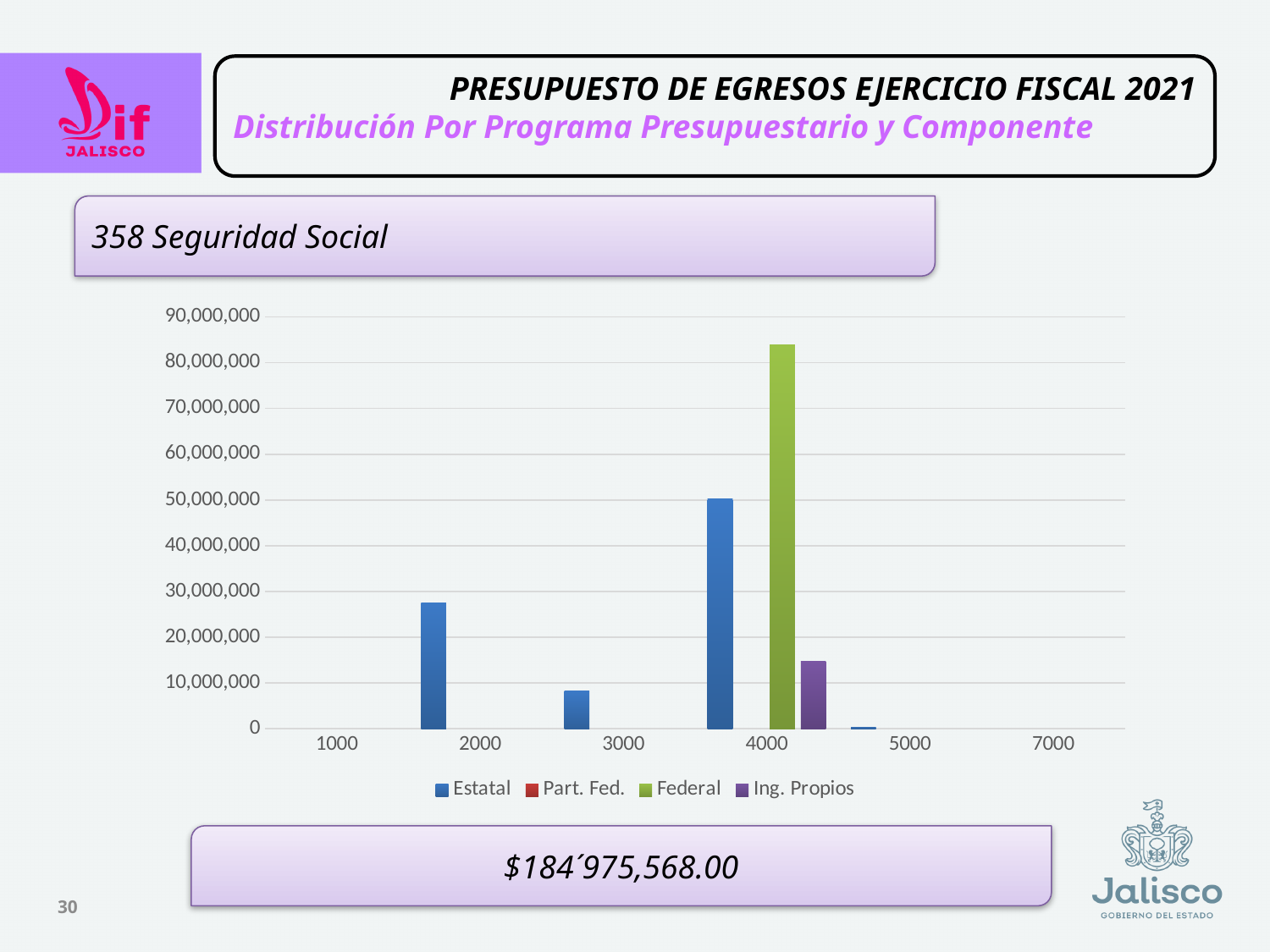
What is the title of the program shown above the chart? 358 Seguridad Social Is the Estatal value for category 2000 greater or less than 30,000,000? less What colour represents the Federal series in the legend? green How many series does the legend list? 4 What kind of chart is shown on the slide? bar chart Is the Federal value for category 4000 greater or less than 80,000,000? greater How many categories are shown on the x axis? 6 Which category has the tallest Estatal bar? 4000 Is the Estatal value for category 4000 greater or less than 40,000,000? greater For category 4000, which is larger: the Federal bar or the Estatal bar? Federal